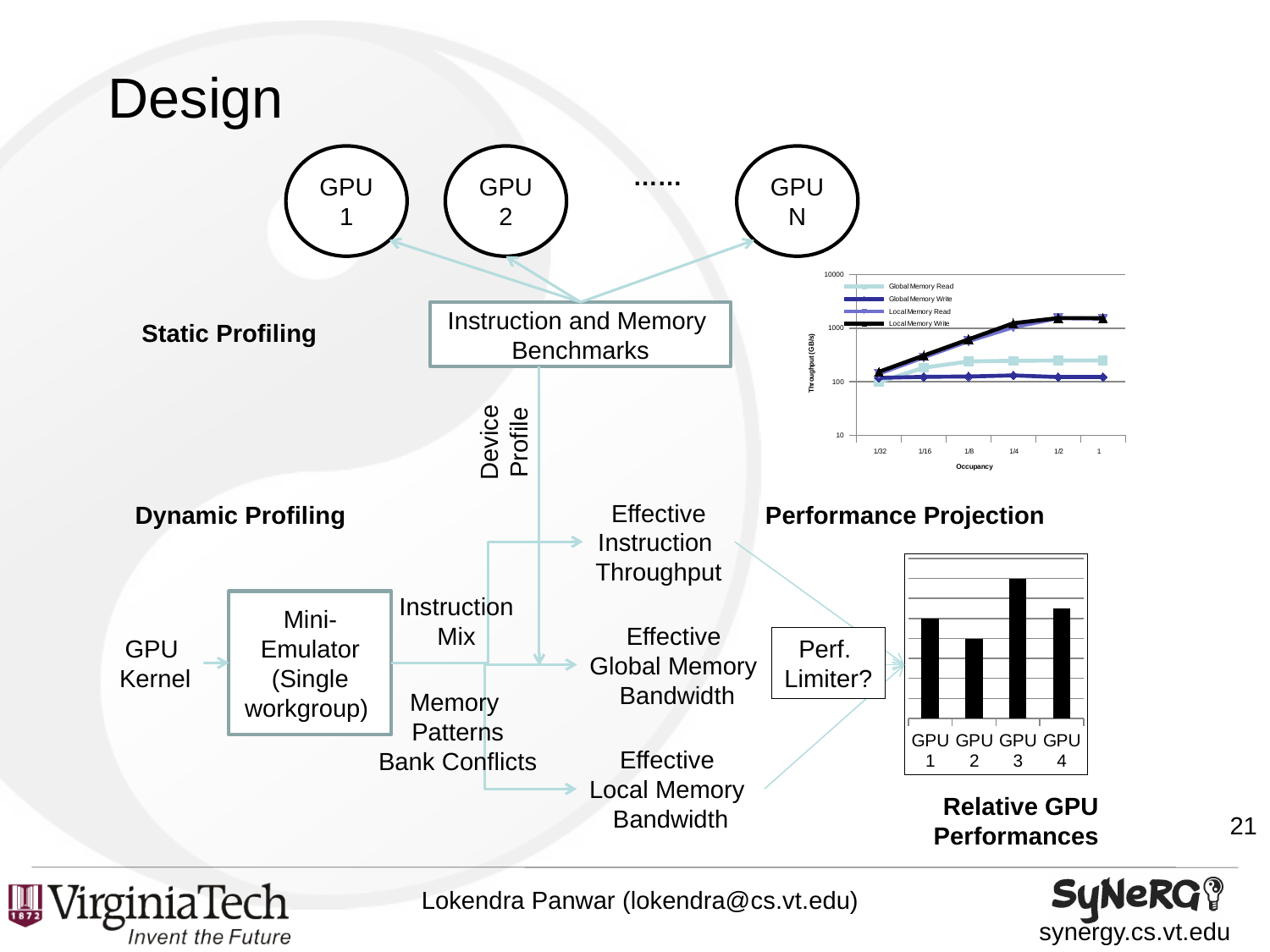
In the 'Relative GPU Performances' chart, which GPU has the shortest bar? GPU 2 In the throughput versus occupancy chart, is the Local Memory Write value at occupancy 1 greater or less than 1000? greater In the throughput versus occupancy chart, which series has the lowest throughput at occupancy 1? Global Memory Write How many series does the legend of the throughput versus occupancy chart list? 4 What kind of chart is the 'Relative GPU Performances' chart? bar chart What kind of chart is the throughput versus occupancy chart in the upper right? line chart In the 'Relative GPU Performances' chart, how many GPUs are shown on the x axis? 4 In the 'Relative GPU Performances' chart, which bar is taller, GPU 2 or GPU 3? GPU 3 In the throughput versus occupancy chart, does the Local Memory Write series rise or fall as occupancy increases from 1/32 to 1? rise In the 'Relative GPU Performances' chart, which GPU has the tallest bar? GPU 3 How many occupancy values are marked on the x axis of the throughput versus occupancy chart? 6 In the throughput versus occupancy chart, is the Global Memory Write value at occupancy 1 greater or less than 1000? less